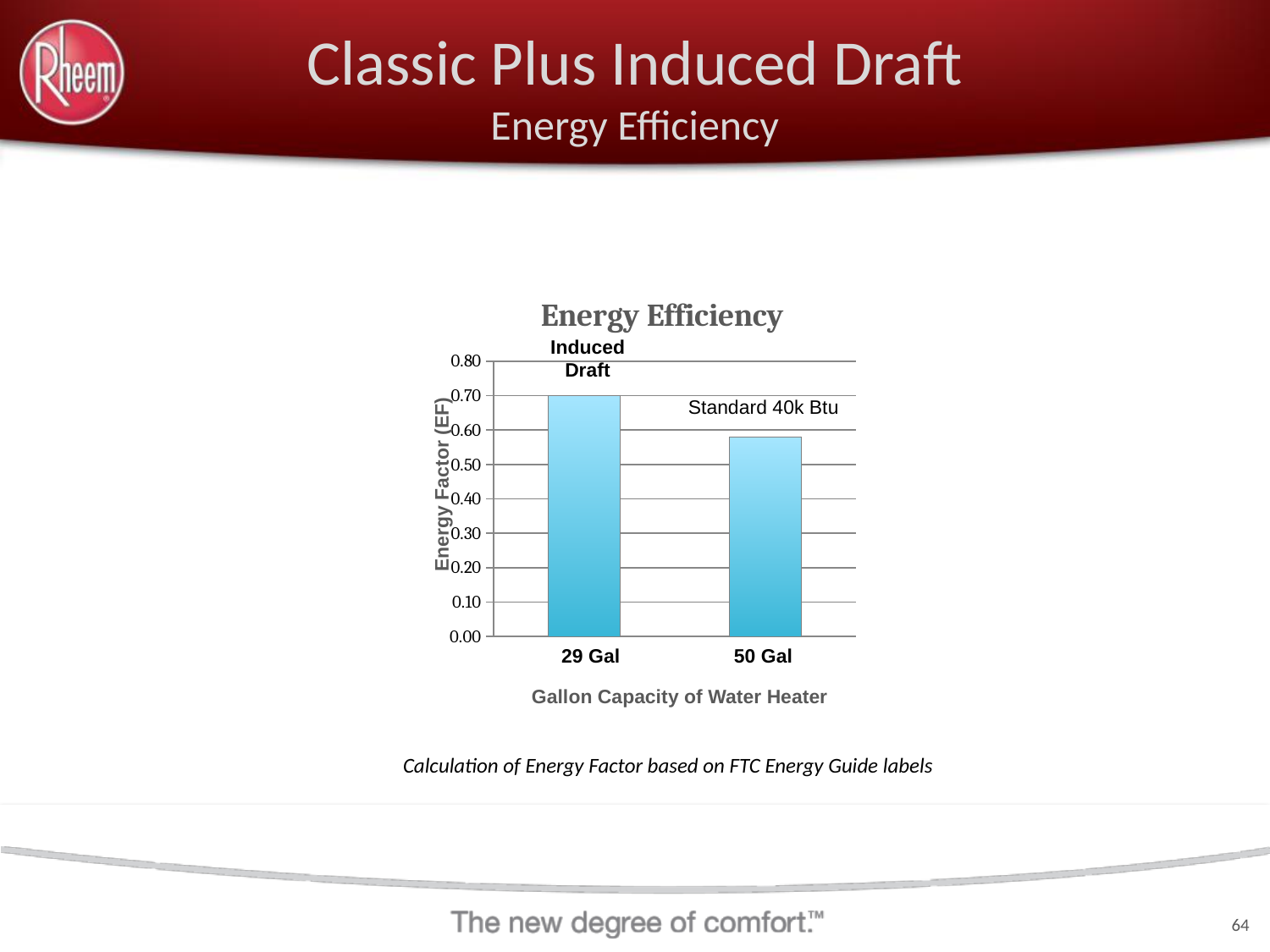
What kind of chart is shown on the slide? bar chart Which gallon capacity has the lowest Energy Factor? 50 Gal Is the Energy Factor value for the 29 Gal water heater greater or less than 0.60? greater What is the title of the chart? Energy Efficiency Which has a larger Energy Factor, the 29 Gal or the 50 Gal water heater? 29 Gal Which gallon capacity has the highest Energy Factor? 29 Gal Is the Energy Factor value for the 50 Gal water heater greater or less than 0.50? greater What is the label of the x axis of the chart? Gallon Capacity of Water Heater Is the Energy Factor value for the 50 Gal water heater greater or less than 0.60? less How many gallon capacity categories are plotted in the chart? 2 Do the Energy Factor values rise or fall from 29 Gal to 50 Gal along the x axis? fall What is the Energy Factor (EF) value for the 29 Gal water heater? 0.70